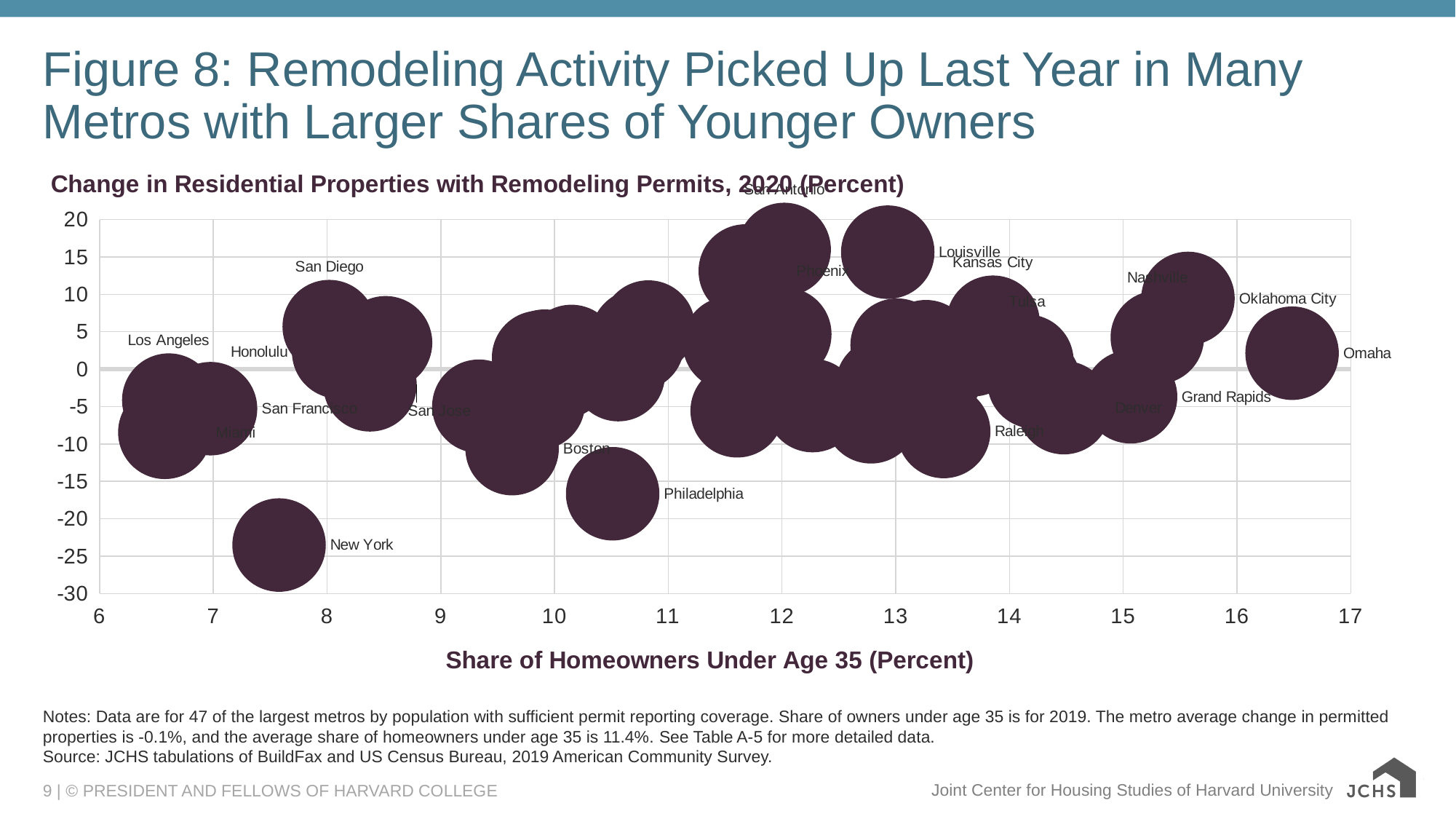
What kind of chart is shown on the slide? bubble chart Is the share of homeowners under age 35 for Omaha greater or less than 16? greater Is the change in remodeling permits for New York greater or less than -20? less Which metro has the largest share of homeowners under age 35? Omaha Is the change in remodeling permits for Louisville greater or less than 10? greater Which metro has the lowest change in residential properties with remodeling permits? New York Which metro has the highest change in residential properties with remodeling permits? San Antonio Which has a higher change in remodeling permits, Philadelphia or New York? Philadelphia What is the label of the horizontal axis? Share of Homeowners Under Age 35 (Percent) What is the chart's subtitle describing the vertical axis measure? Change in Residential Properties with Remodeling Permits, 2020 (Percent)